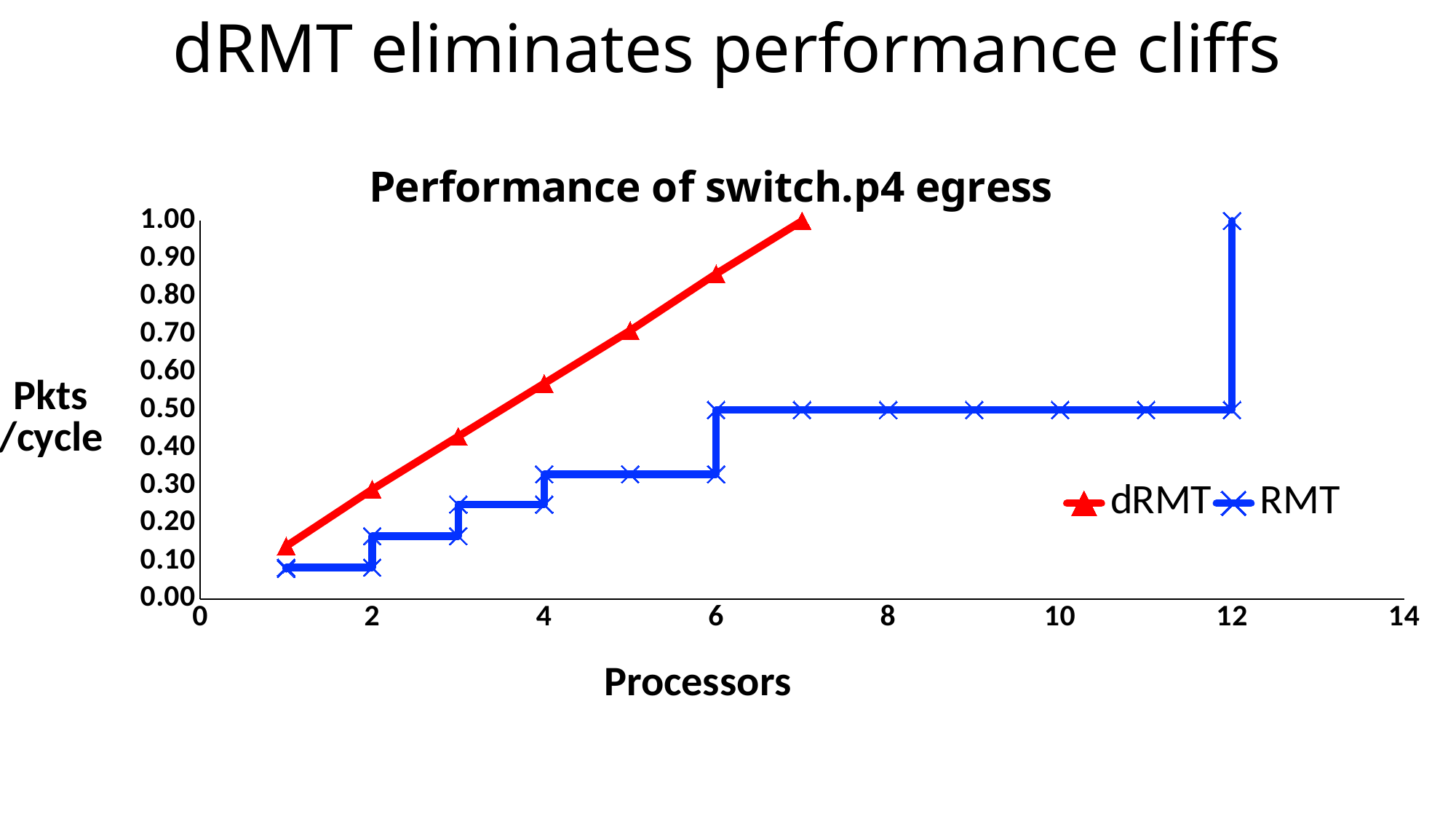
Is the RMT value at 2 processors greater or less than 0.10? less Do the dRMT values rise or fall as the number of processors increases? rise Is the dRMT value at 5 processors greater or less than 0.60? greater At 4 processors, which series has the higher value, dRMT or RMT? dRMT What is the label on the y axis of the chart? Pkts/cycle Is the dRMT value at 3 processors greater or less than 0.50? less What is the RMT value at 8 processors? 0.50 How many data points are plotted for the dRMT series? 7 What is the dRMT value at 7 processors? 1.00 What is the title of the chart? Performance of switch.p4 egress What kind of chart is shown on the slide? line chart How many series does the legend list? 2